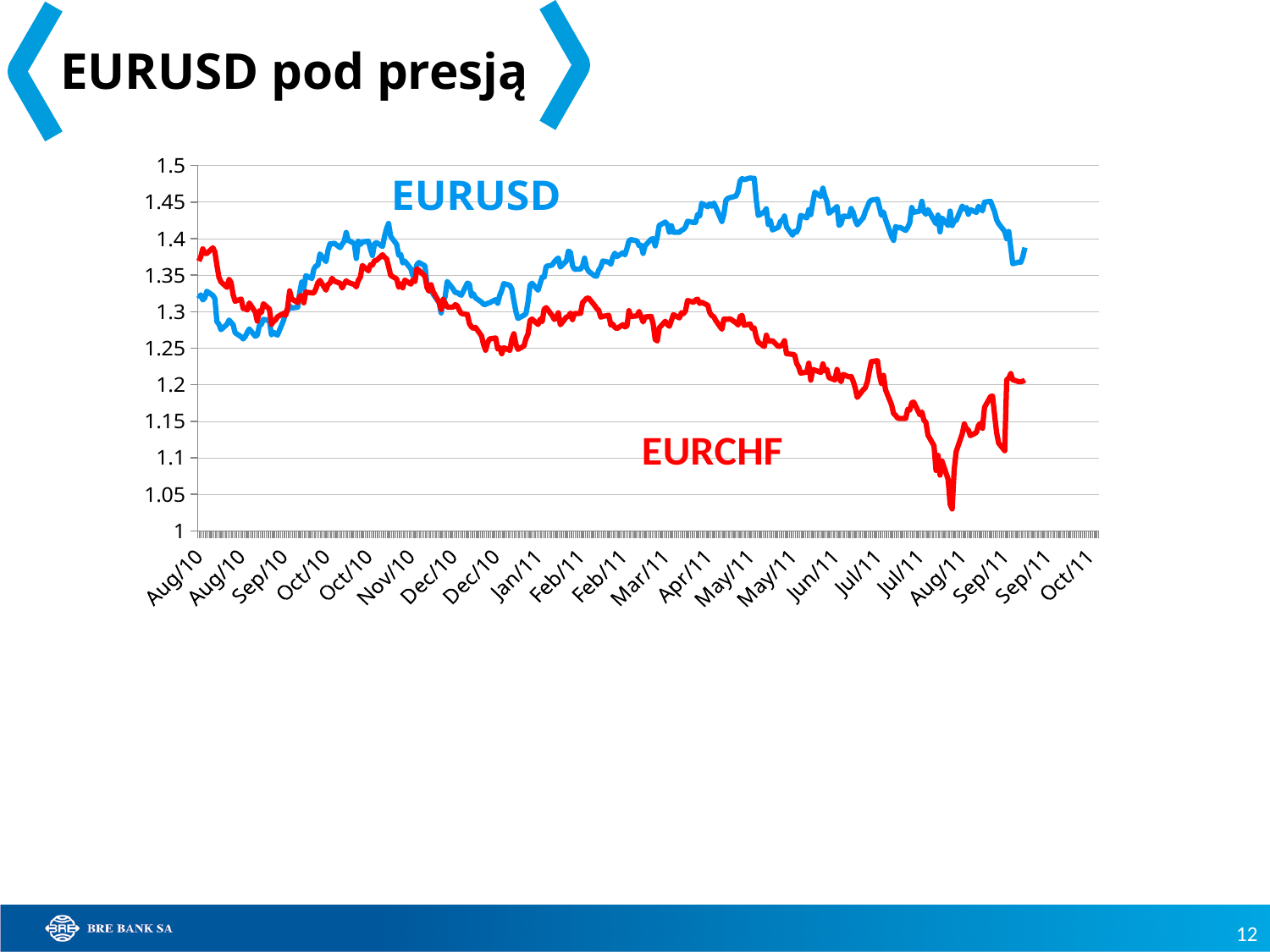
Is the value of EURUSD at the end of the chart (Sep/11) greater or less than 1.4? less How many series are plotted on the chart? 2 Is the lowest value of the EURCHF line, around Aug/11, greater or less than 1.05? less What colour is the EURCHF line? red Does the EURCHF line rise or fall between Apr/11 and Aug/11? fall What is the title of the slide's chart? EURUSD pod presją Is the value of EURCHF at the start of the chart (Aug/10) greater or less than 1.35? greater At the start of the chart (Aug/10), which series has the higher value, EURUSD or EURCHF? EURCHF At the end of the chart (Sep/11), which series has the higher value, EURUSD or EURCHF? EURUSD What kind of chart is shown on the slide? line chart